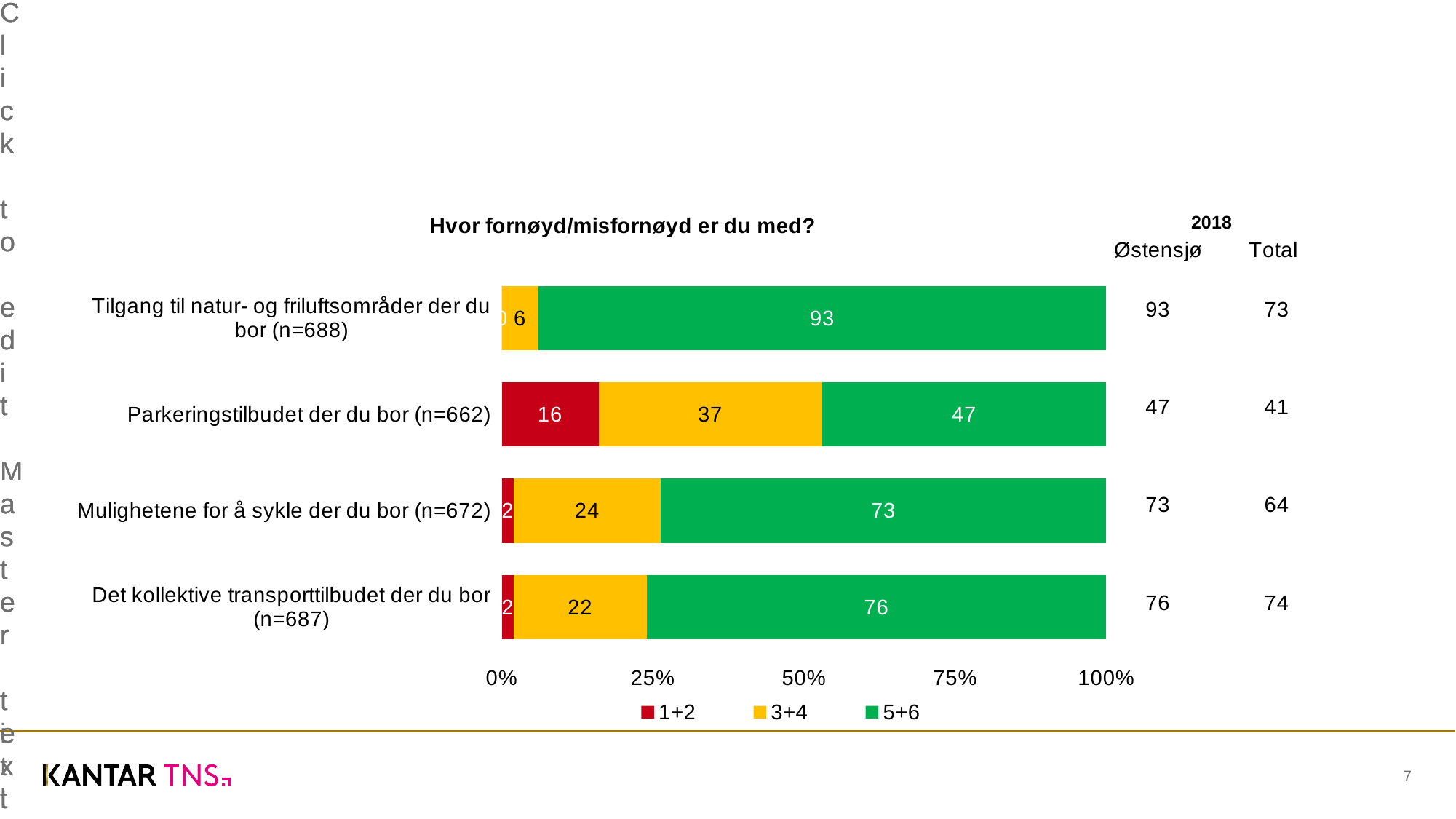
How many series does the legend list? 3 What is the 1+2 value for 'Parkeringstilbudet der du bor (n=662)'? 16 What is the chart's title? Hvor fornøyd/misfornøyd er du med? How many categories are plotted in the chart? 4 Which category has the lowest 5+6 value? Parkeringstilbudet der du bor (n=662) Which category has the highest 5+6 value? Tilgang til natur- og friluftsområder der du bor (n=688) What is the 5+6 value for 'Det kollektive transporttilbudet der du bor (n=687)'? 76 What is the 5+6 value for 'Tilgang til natur- og friluftsområder der du bor (n=688)'? 93 What is the 3+4 value for 'Mulighetene for å sykle der du bor (n=672)'? 24 Which is larger: the 3+4 value for 'Parkeringstilbudet der du bor (n=662)' or the 3+4 value for 'Det kollektive transporttilbudet der du bor (n=687)'? Parkeringstilbudet der du bor (n=662) What is the difference between the 5+6 values for 'Det kollektive transporttilbudet der du bor (n=687)' and 'Mulighetene for å sykle der du bor (n=672)'? 3 What type of chart is shown on the slide? Stacked bar chart